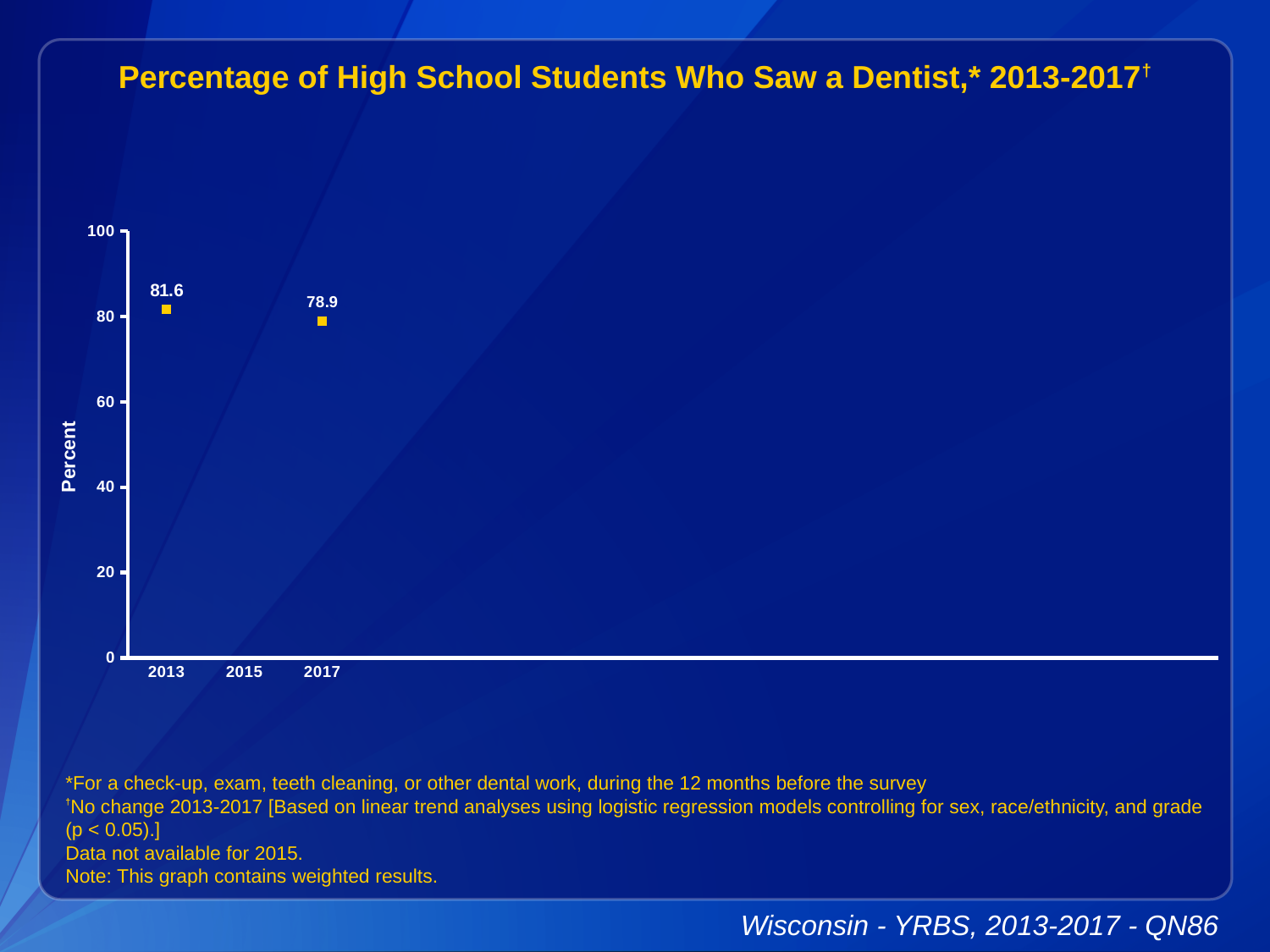
What is the percentage of high school students who saw a dentist in 2013? 81.6 Is the value for 2013 greater or less than 80? greater What is the maximum value shown on the vertical axis? 100 How many data points are plotted on the chart? 2 Which year has the higher percentage of students who saw a dentist, 2013 or 2017? 2013 What is the percentage of high school students who saw a dentist in 2017? 78.9 Is the value for 2017 greater or less than 80? less Do the plotted values rise or fall from 2013 to 2017? fall What is the difference between the 2013 and 2017 percentages of students who saw a dentist? 2.7 What is the label on the vertical axis of the chart? Percent Which year shows the lowest plotted percentage of students who saw a dentist? 2017 Which year on the x axis has no data plotted? 2015